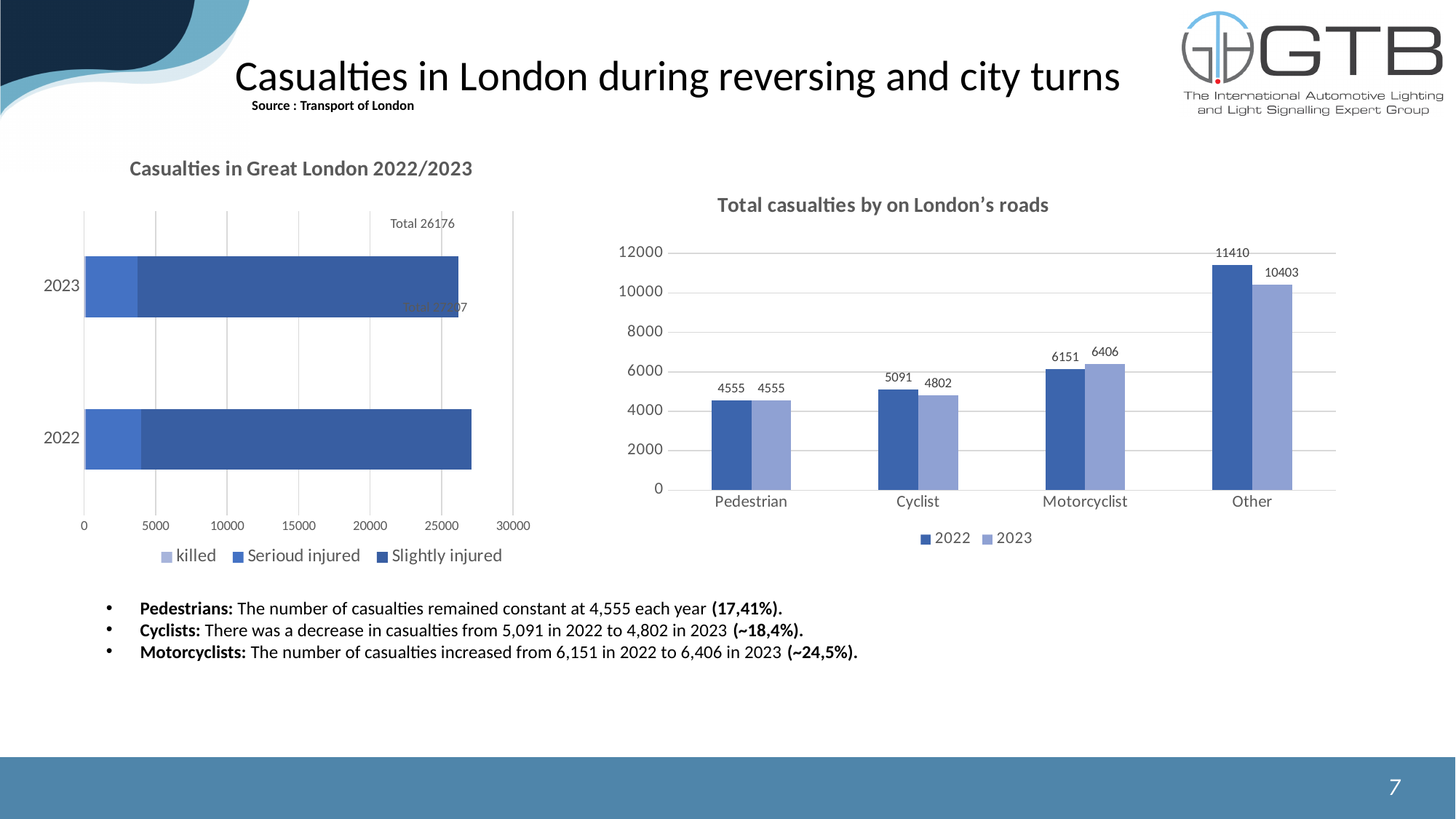
In the chart titled 'Casualties in Great London 2022/2023', how many series does the legend list? 3 In the chart titled 'Total casualties by on London's roads', what is the value for Other in 2022? 11410 What kind of chart is the chart titled 'Casualties in Great London 2022/2023'? Stacked bar chart In the chart titled 'Total casualties by on London's roads', how many series does the legend list? 2 In the chart titled 'Casualties in Great London 2022/2023', what is the total shown for 2023? 26176 In the chart titled 'Total casualties by on London's roads', how many categories are shown on the x axis? 4 In the chart titled 'Total casualties by on London's roads', which category has the lowest value in 2022? Pedestrian In the chart titled 'Total casualties by on London's roads', what is the value for Motorcyclist in 2023? 6406 In the chart titled 'Total casualties by on London's roads', what is the difference between the 2022 and 2023 values for Other? 1007 In the chart titled 'Total casualties by on London's roads', which category has the highest value in 2023? Other In the chart titled 'Total casualties by on London's roads', what is the value for Cyclist in 2022? 5091 In the chart titled 'Total casualties by on London's roads', which is larger for Cyclist: the 2022 value or the 2023 value? 2022